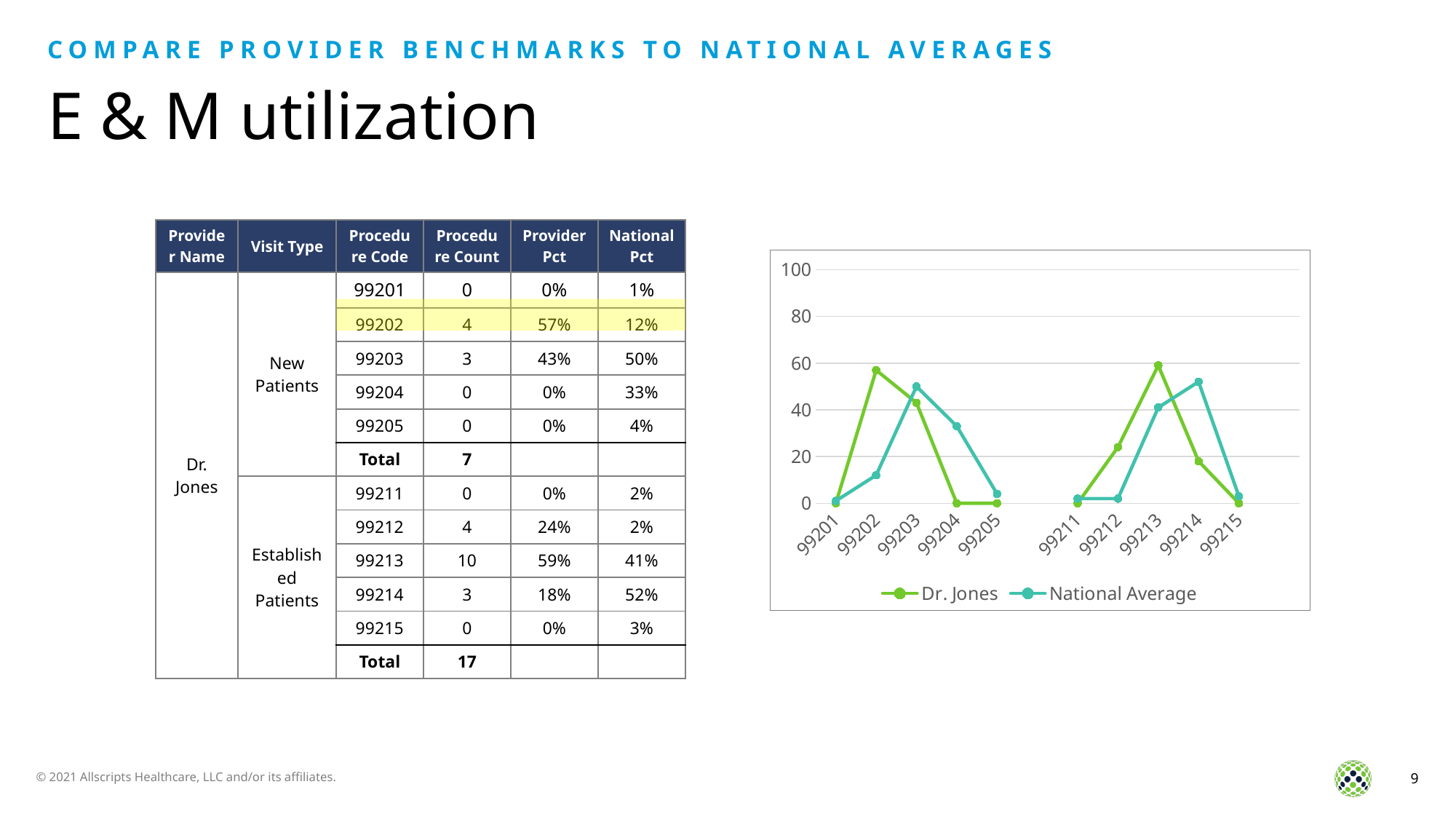
In the chart, does the Dr. Jones line rise or fall from 99213 to 99215? fall In the chart, is the National Average value for 99204 greater or less than 20? greater In the chart, which series has the higher value at 99202, Dr. Jones or National Average? Dr. Jones In the chart, is the Dr. Jones value for 99202 greater or less than 40? greater In the chart, is the National Average value for 99202 greater or less than 20? less How many procedure codes are shown on the x axis of the chart? 10 In the chart, which series has the higher value at 99214, Dr. Jones or National Average? National Average What kind of chart is shown on the slide? line chart In the chart, which series has the higher value at 99204, Dr. Jones or National Average? National Average How many series does the chart legend list? 2 In the chart, what is the Dr. Jones value for 99201? 0